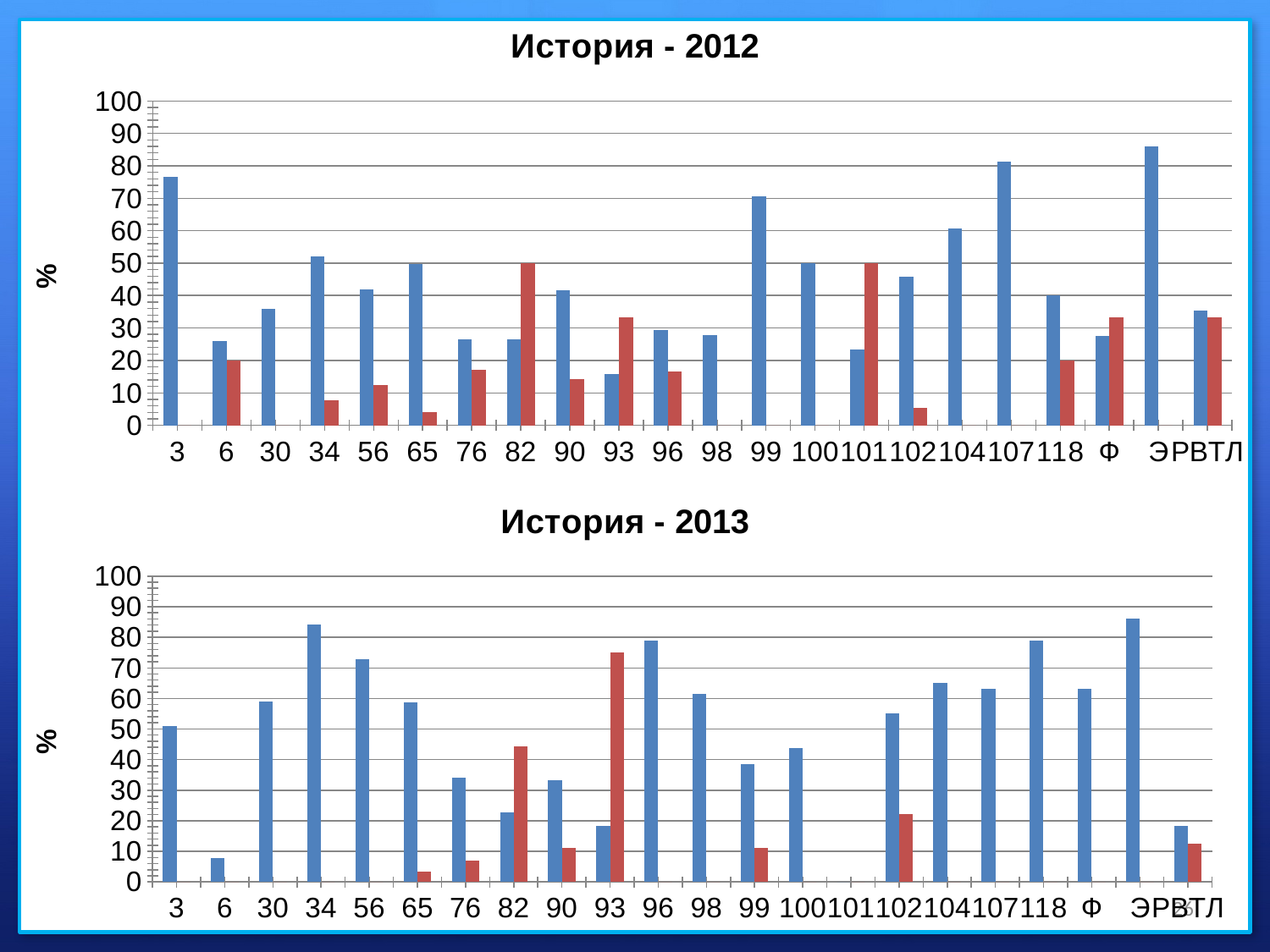
What kind of chart is the top chart titled "История - 2012"? bar chart In the "История - 2012" chart, is the blue bar for category 3 greater or less than 70? greater In the "История - 2013" chart, is the blue bar for category 6 greater or less than 10? less In the "История - 2013" chart, which blue bar is taller, category 96 or category 98? 96 What is the title of the bottom chart on the slide? История - 2013 In the "История - 2012" chart, which blue bar is taller, category 99 or category 100? 99 In the "История - 2012" chart, which category has the shortest blue bar? 93 In the "История - 2013" chart, which category has the tallest red bar? 93 In the "История - 2012" chart, which category has the tallest blue bar? Э In the "История - 2013" chart, is the blue bar for category 34 greater or less than 80? greater In the "История - 2012" chart, what label is shown on the vertical axis? %